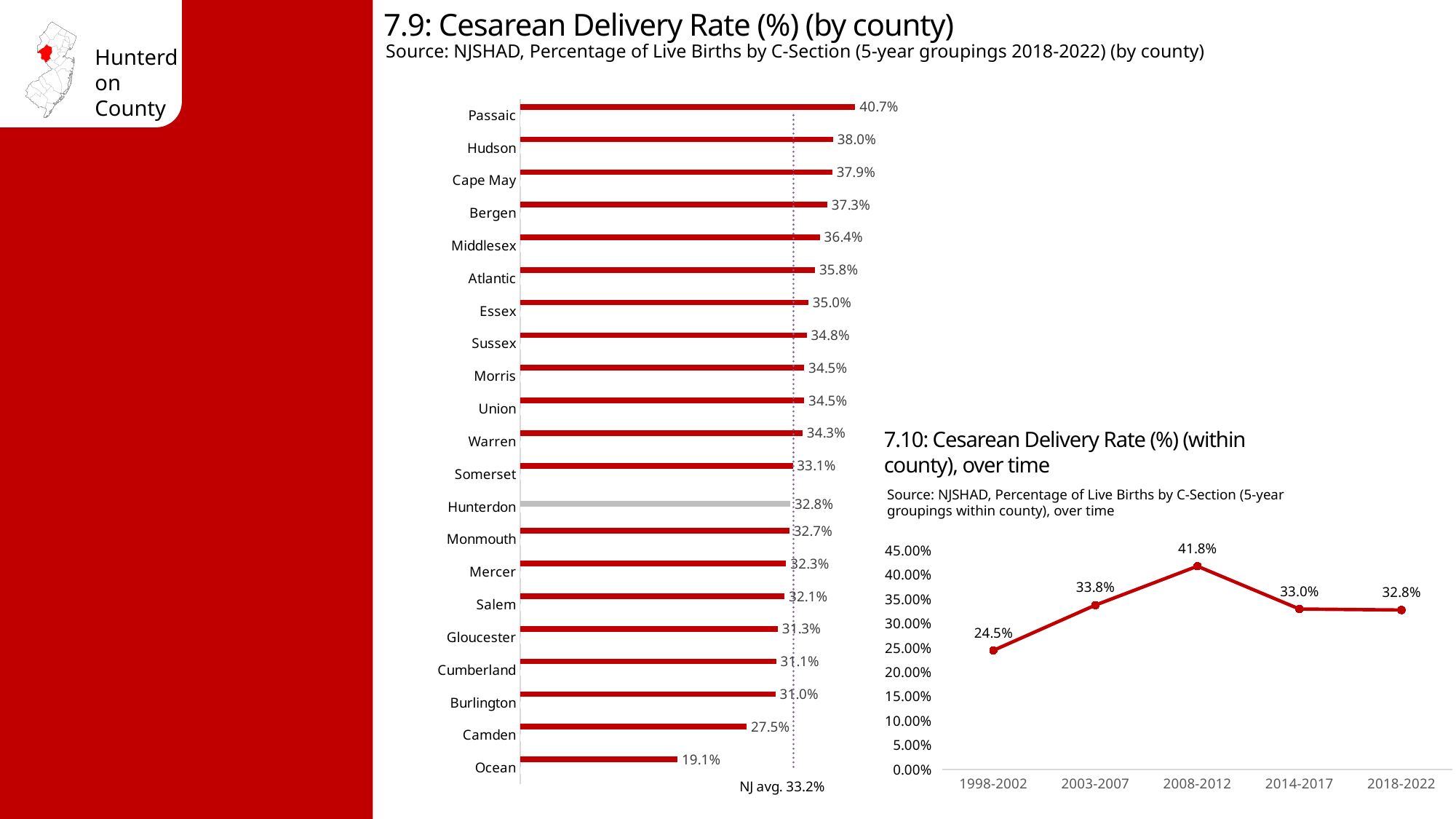
In the 7.10 Cesarean Delivery Rate (within county) over time chart, how many time periods are plotted? 5 In the 7.9 Cesarean Delivery Rate (by county) chart, how many counties are shown? 21 In the 7.9 Cesarean Delivery Rate (by county) chart, which county has the lowest rate? Ocean In the 7.9 Cesarean Delivery Rate (by county) chart, which is larger, Bergen or Camden? Bergen In the 7.10 Cesarean Delivery Rate (within county) over time chart, what is the difference between 2008-2012 and 1998-2002? 17.3% In the 7.9 Cesarean Delivery Rate (by county) chart, what NJ average is marked by the dotted line? 33.2% In the 7.9 Cesarean Delivery Rate (by county) chart, what is the value for Cape May? 37.9% What kind of chart is the 7.10 Cesarean Delivery Rate (within county) over time chart? line chart In the 7.10 Cesarean Delivery Rate (within county) over time chart, what is the value for 2008-2012? 41.8% In the 7.9 Cesarean Delivery Rate (by county) chart, which county has the highest rate? Passaic In the 7.9 Cesarean Delivery Rate (by county) chart, what is the difference between Passaic and Ocean? 21.6% In the 7.9 Cesarean Delivery Rate (by county) chart, what is the value for Hunterdon? 32.8%